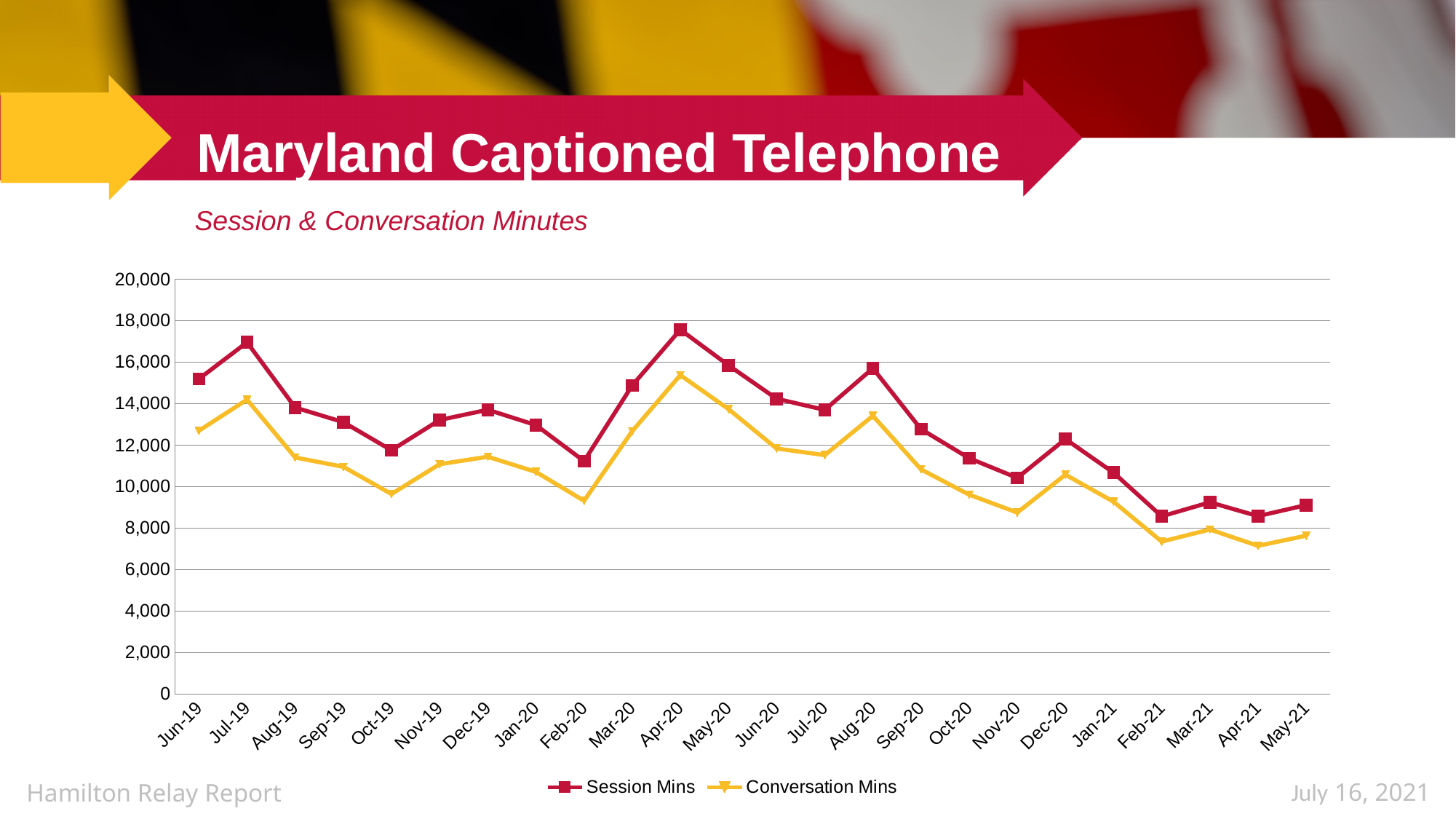
What is the subtitle shown above the chart? Session & Conversation Minutes In which month does Session Mins reach its highest value? Apr-20 Is the value for Conversation Mins in Feb-20 greater or less than 10,000? less How many series does the legend list? 2 Which is larger for Session Mins: Jul-19 or Aug-19? Jul-19 What kind of chart is shown on the slide? line chart Is the value for Session Mins in Oct-19 greater or less than 10,000? greater Is the value for Conversation Mins in May-21 greater or less than 8,000? less In which month does Conversation Mins reach its highest value? Apr-20 How many months are plotted along the x axis? 24 Overall, do the Session Mins values rise or fall from Jun-19 to May-21? fall